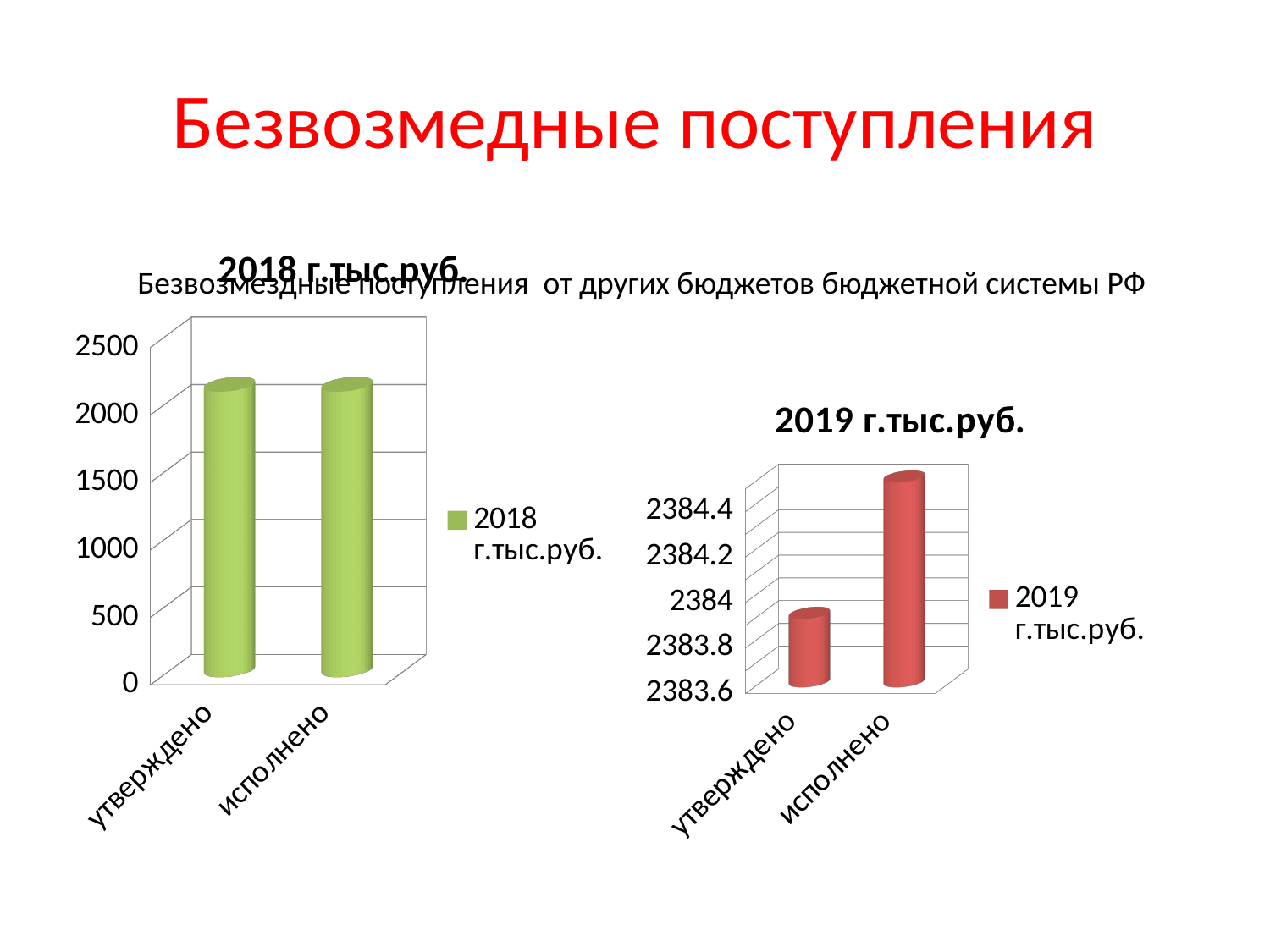
How many categories are shown on the x axis of the "2019 г.тыс.руб." chart? 2 In the "2019 г.тыс.руб." chart, is the value for утверждено greater or less than 2384? less In the "2018 г.тыс.руб." chart, is the value for утверждено greater or less than 2000? greater In the "2019 г.тыс.руб." chart, is the value for исполнено greater or less than 2384.4? greater In the "2019 г.тыс.руб." chart, which category has the higher value, утверждено or исполнено? исполнено How many categories are shown on the x axis of the "2018 г.тыс.руб." chart? 2 How many series does the legend of the "2019 г.тыс.руб." chart list? 1 What is the legend entry of the "2018 г.тыс.руб." chart? 2018 г.тыс.руб. What kind of chart is the "2019 г.тыс.руб." chart on the right? bar chart How many series does the legend of the "2018 г.тыс.руб." chart list? 1 What kind of chart is the "2018 г.тыс.руб." chart on the left? bar chart